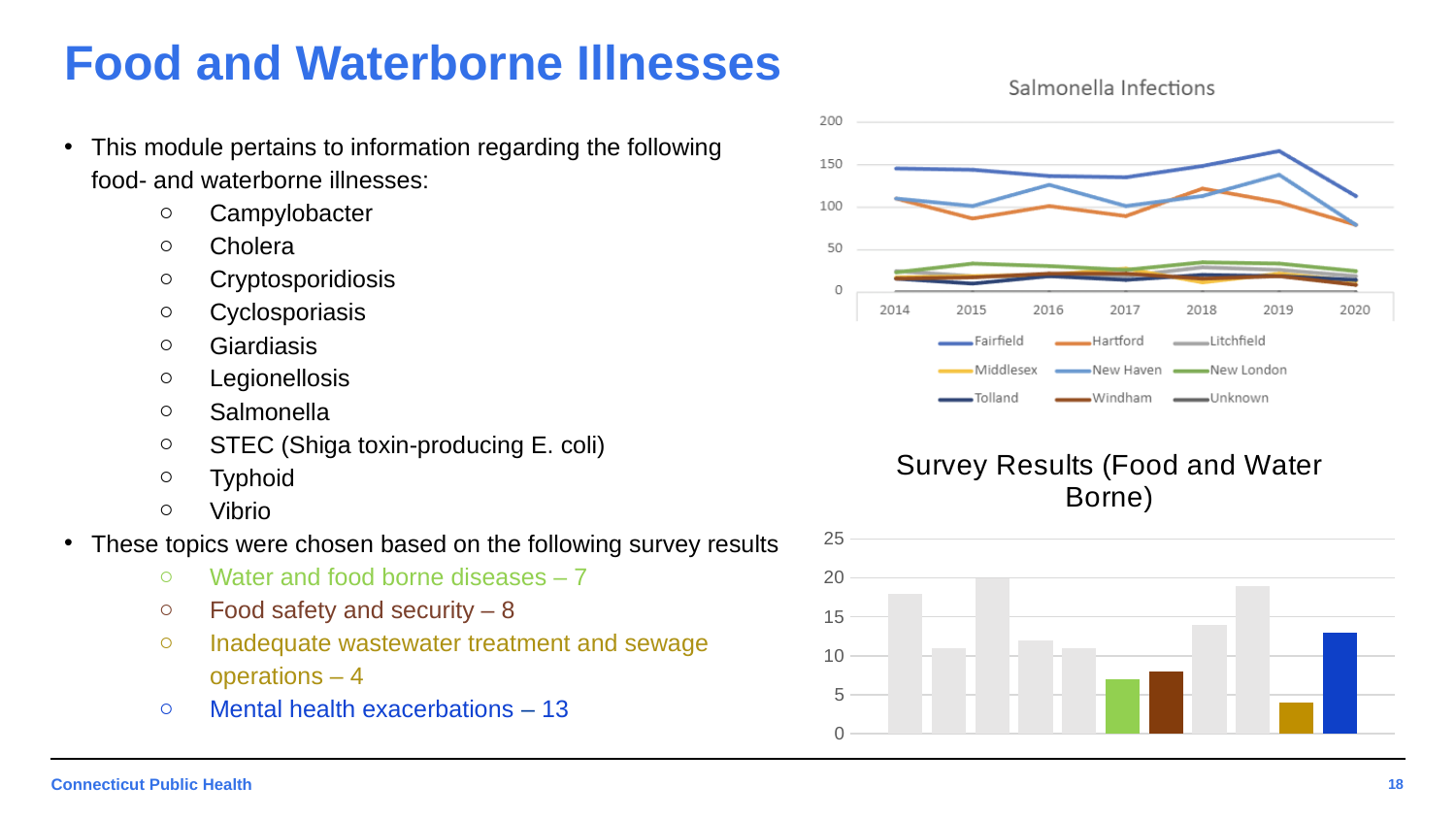
In the Salmonella Infections chart, which is larger in 2020, Fairfield or New Haven? Fairfield In the Salmonella Infections chart, which county has the highest number of infections across the years shown? Fairfield In the Salmonella Infections chart, how many series does the legend list? 9 In the Survey Results (Food and Water Borne) chart, is the blue bar greater or less than 10? greater In the Salmonella Infections chart, is the value for Hartford in 2015 greater or less than 100? less In the Salmonella Infections chart, does the Fairfield line rise or fall from 2019 to 2020? fall In the Survey Results (Food and Water Borne) chart, is the green bar greater or less than 10? less What type of chart is the Survey Results (Food and Water Borne) chart? bar chart In the Salmonella Infections chart, how many years are shown on the x axis? 7 In the Survey Results (Food and Water Borne) chart, how many bars are plotted? 11 What type of chart is the Salmonella Infections chart? line chart